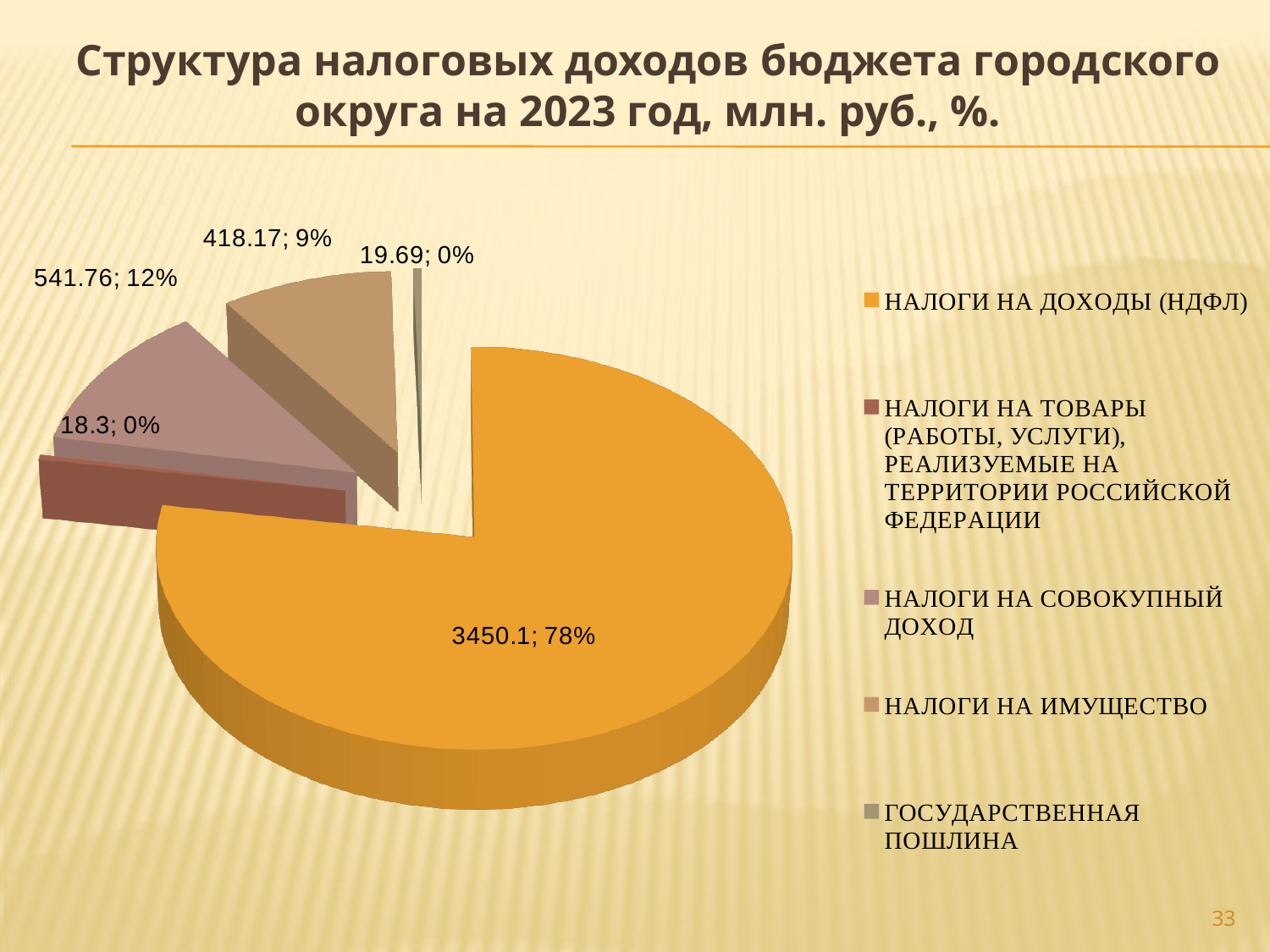
What is the value for ГОСУДАРСТВЕННАЯ ПОШЛИНА? 19.69 Which category has the lowest value? НАЛОГИ НА ТОВАРЫ (РАБОТЫ, УСЛУГИ), РЕАЛИЗУЕМЫЕ НА ТЕРРИТОРИИ РОССИЙСКОЙ ФЕДЕРАЦИИ Which is larger: the value for НАЛОГИ НА СОВОКУПНЫЙ ДОХОД or the value for НАЛОГИ НА ИМУЩЕСТВО? НАЛОГИ НА СОВОКУПНЫЙ ДОХОД What is the difference between the values for НАЛОГИ НА СОВОКУПНЫЙ ДОХОД and НАЛОГИ НА ИМУЩЕСТВО? 123.59 Which category has the highest value? НАЛОГИ НА ДОХОДЫ (НДФЛ) What kind of chart is shown on the slide? pie chart What is the value for НАЛОГИ НА ИМУЩЕСТВО? 418.17 What is the value for НАЛОГИ НА ДОХОДЫ (НДФЛ)? 3450.1 What share of the pie does НАЛОГИ НА ДОХОДЫ (НДФЛ) represent? 78% What is the value for НАЛОГИ НА СОВОКУПНЫЙ ДОХОД? 541.76 How many slices does the pie chart have? 5 What share of the pie does НАЛОГИ НА ИМУЩЕСТВО represent? 9%